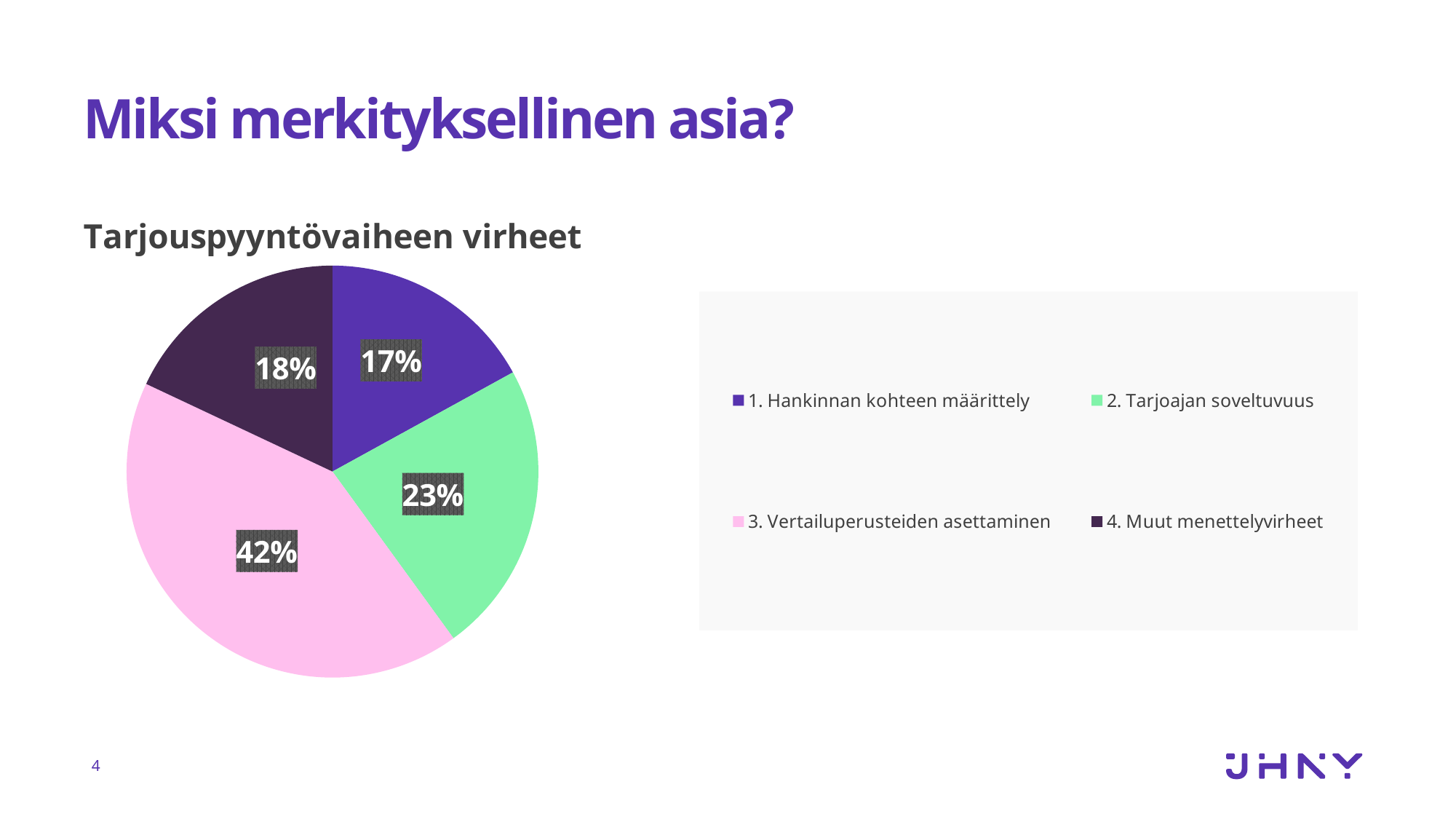
What is the value for '2. Tarjoajan soveltuvuus'? 23% Which category has the smallest slice of the pie? 1. Hankinnan kohteen määrittely What colour is the slice for '2. Tarjoajan soveltuvuus'? Green What is the value for '4. Muut menettelyvirheet'? 18% Which is larger, the share for '2. Tarjoajan soveltuvuus' or for '4. Muut menettelyvirheet'? 2. Tarjoajan soveltuvuus How many categories does the pie chart have? 4 What kind of chart is shown on the slide? Pie chart What is the value for '1. Hankinnan kohteen määrittely'? 17% What share of the pie does '3. Vertailuperusteiden asettaminen' have? 42% What is the title of the chart? Tarjouspyyntövaiheen virheet Which category has the largest slice of the pie? 3. Vertailuperusteiden asettaminen What is the difference between the shares of '3. Vertailuperusteiden asettaminen' and '2. Tarjoajan soveltuvuus'? 19%